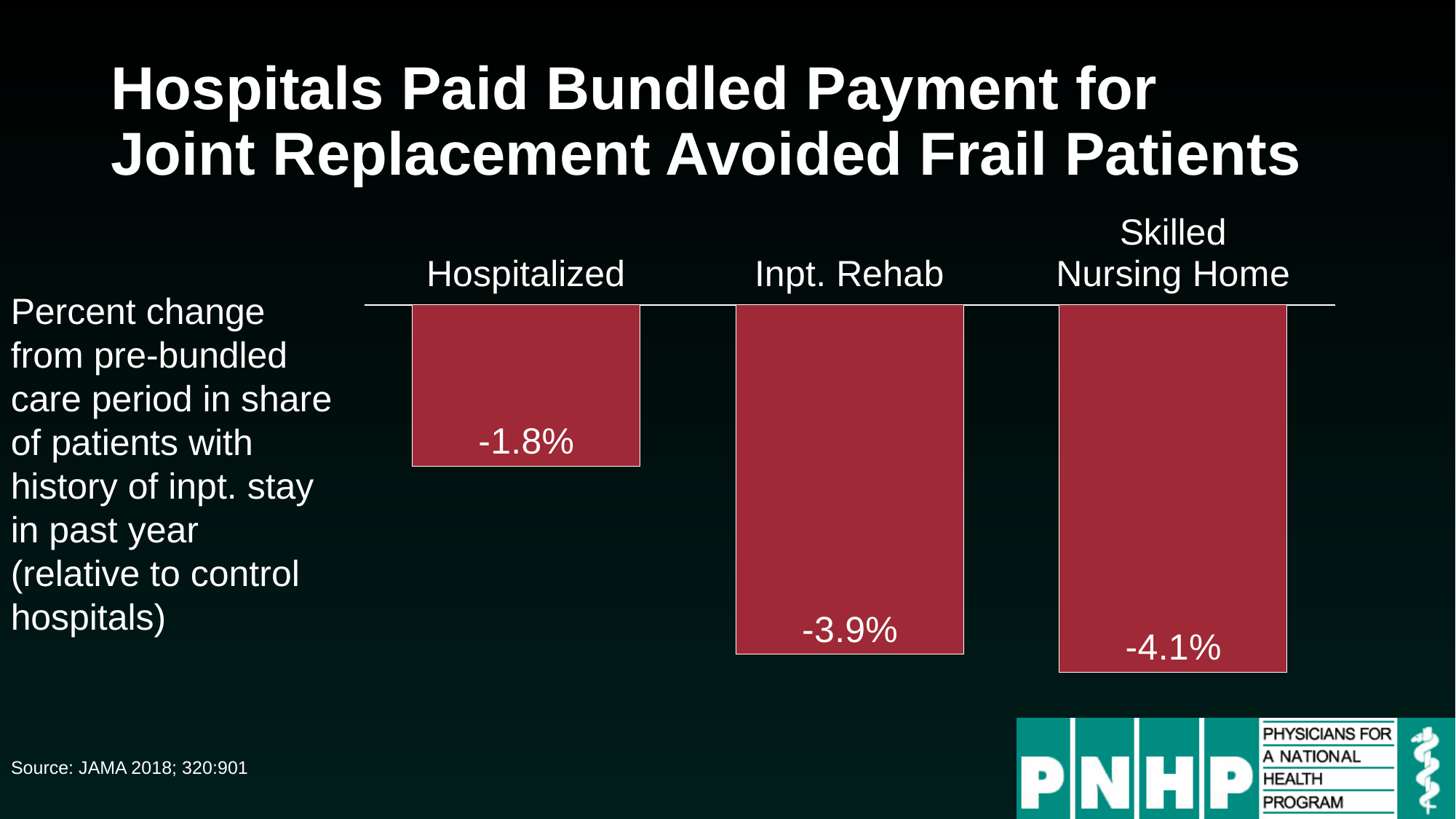
How many categories are shown in the chart? 3 Which category has the smallest decrease? Hospitalized What is the difference between the Hospitalized and Skilled Nursing Home values? 2.3 percentage points Which category has the largest decrease? Skilled Nursing Home What kind of chart is shown on the slide? Bar chart What is the percent change for Skilled Nursing Home? -4.1% Which shows a larger decrease, Inpt. Rehab or Hospitalized? Inpt. Rehab What is the difference between the Inpt. Rehab and Hospitalized values? 2.1 percentage points What colour are the bars in the chart? Red What is the percent change for Inpt. Rehab? -3.9% What is the percent change for Hospitalized? -1.8% Do the values decrease or increase moving from left to right across the categories? Decrease